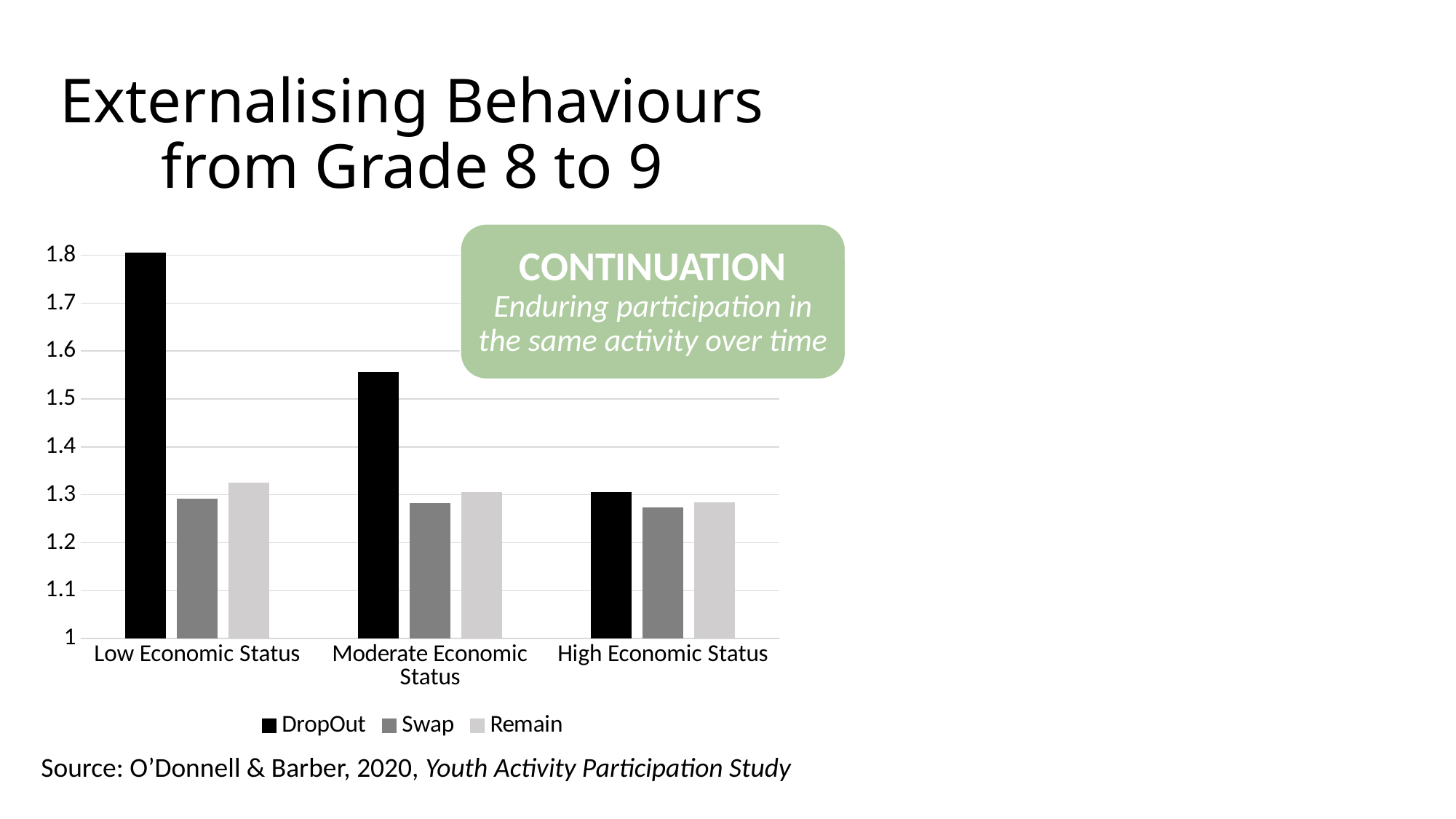
Is the DropOut value for Moderate Economic Status greater or less than 1.5? greater Do the DropOut values rise or fall moving from Low Economic Status to High Economic Status? fall Which economic status category has the lowest DropOut value? High Economic Status Which economic status category has the highest DropOut value? Low Economic Status What are the three series listed in the legend? DropOut, Swap, Remain Which is larger, the DropOut value for Low Economic Status or the DropOut value for Moderate Economic Status? Low Economic Status Is the DropOut value for Low Economic Status greater or less than 1.7? greater How many series does the legend list? 3 Is the Swap value for High Economic Status greater or less than 1.3? less What kind of chart is shown on the slide? bar chart What colour are the DropOut bars? black How many economic status categories are shown on the x axis? 3